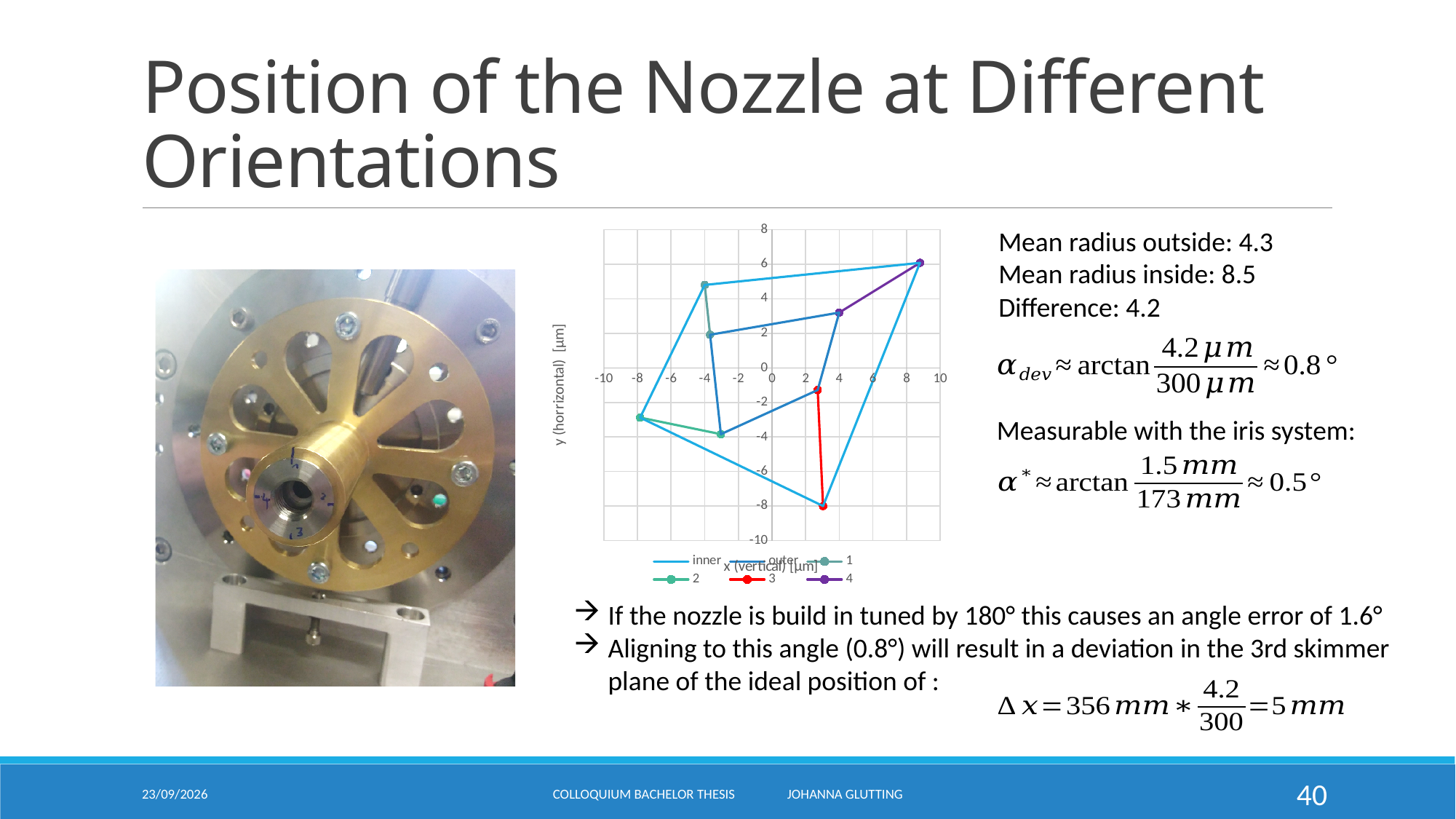
How many data points does the inner series have? 4 What colour is the line for series 3 in the chart? red Is the x value of the leftmost point of the inner series greater or less than -6? less How many data points does the outer series have? 4 What kind of chart is shown on the slide? scatter chart Is the x value of the rightmost point of the inner series greater or less than 8? greater Which series reaches a higher maximum y value, inner or outer? inner How many series does the chart legend list? 6 What is the label of the x axis of the chart? x (vertical) [μm] Is the y value of the highest point of the outer series greater or less than 4? less